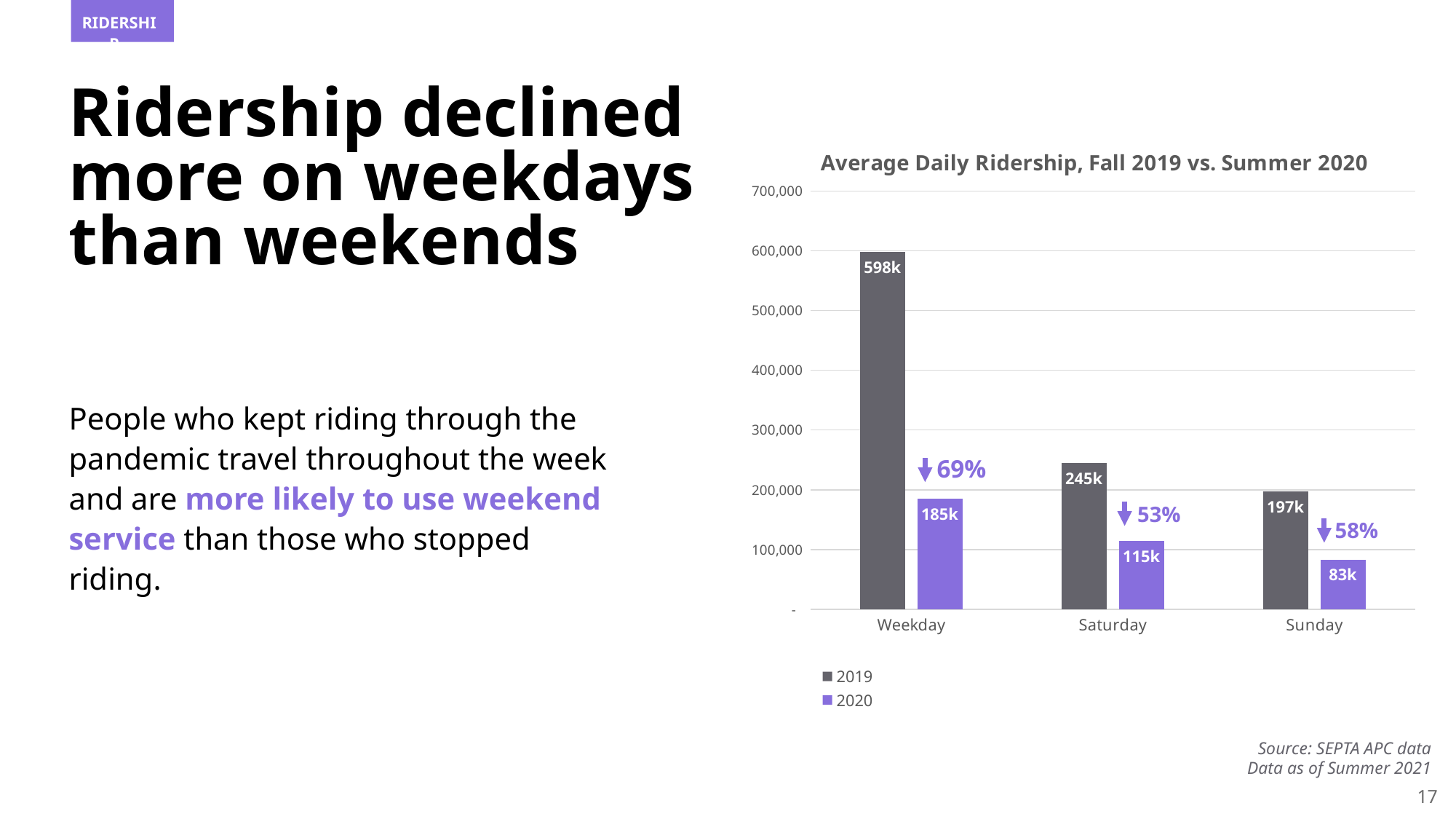
What is the difference between the 2019 and 2020 ridership for Weekday? 413k What is the 2020 average daily ridership for Sunday? 83k What is the 2019 average daily ridership for Weekday? 598k What kind of chart is shown on the slide? bar chart How many categories are shown on the x axis? 3 Which category has the highest 2019 ridership? Weekday Is the 2020 ridership for Weekday greater or less than 200,000? less How many series does the legend list? 2 Which is larger: the 2019 ridership for Saturday or the 2019 ridership for Sunday? Saturday What percentage decline is shown for Saturday? 53% What is the 2020 average daily ridership for Saturday? 115k Which category has the lowest 2020 ridership? Sunday